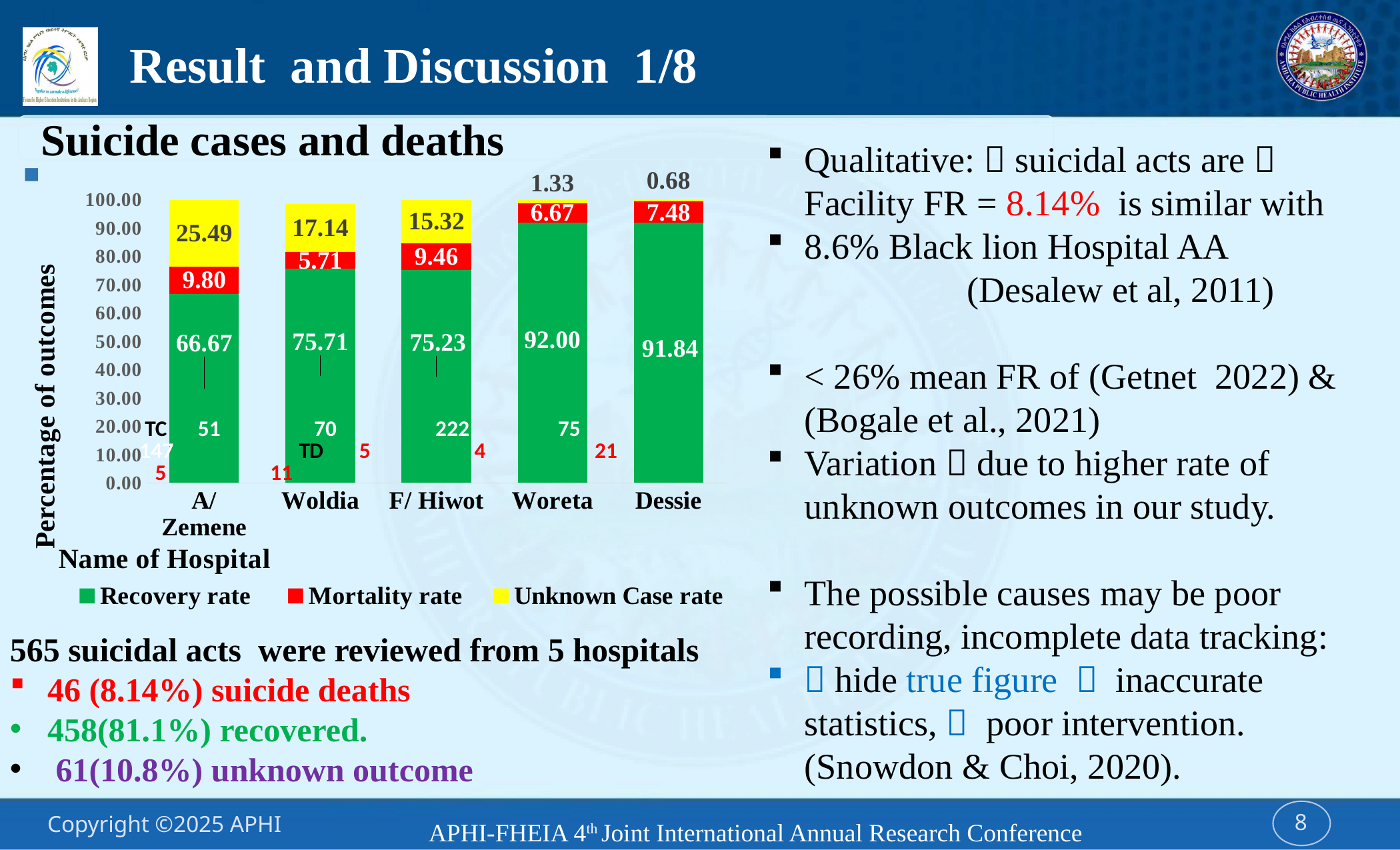
What is the Mortality rate for Dessie? 7.48 What is the Recovery rate for Woreta? 92.00 Which has the larger Mortality rate, Woldia or Woreta? Woreta Which hospital has the highest Unknown Case rate? A/Zemene What is the Mortality rate for A/Zemene? 9.80 How many series does the legend list? 3 What is the difference between the Unknown Case rate for A/Zemene and for Woldia? 8.35 What is the Unknown Case rate for Woldia? 17.14 Which hospital has the highest Recovery rate? Woreta How many hospitals are shown on the x axis? 5 Which hospital has the lowest Unknown Case rate? Dessie What kind of chart is shown? Stacked bar chart